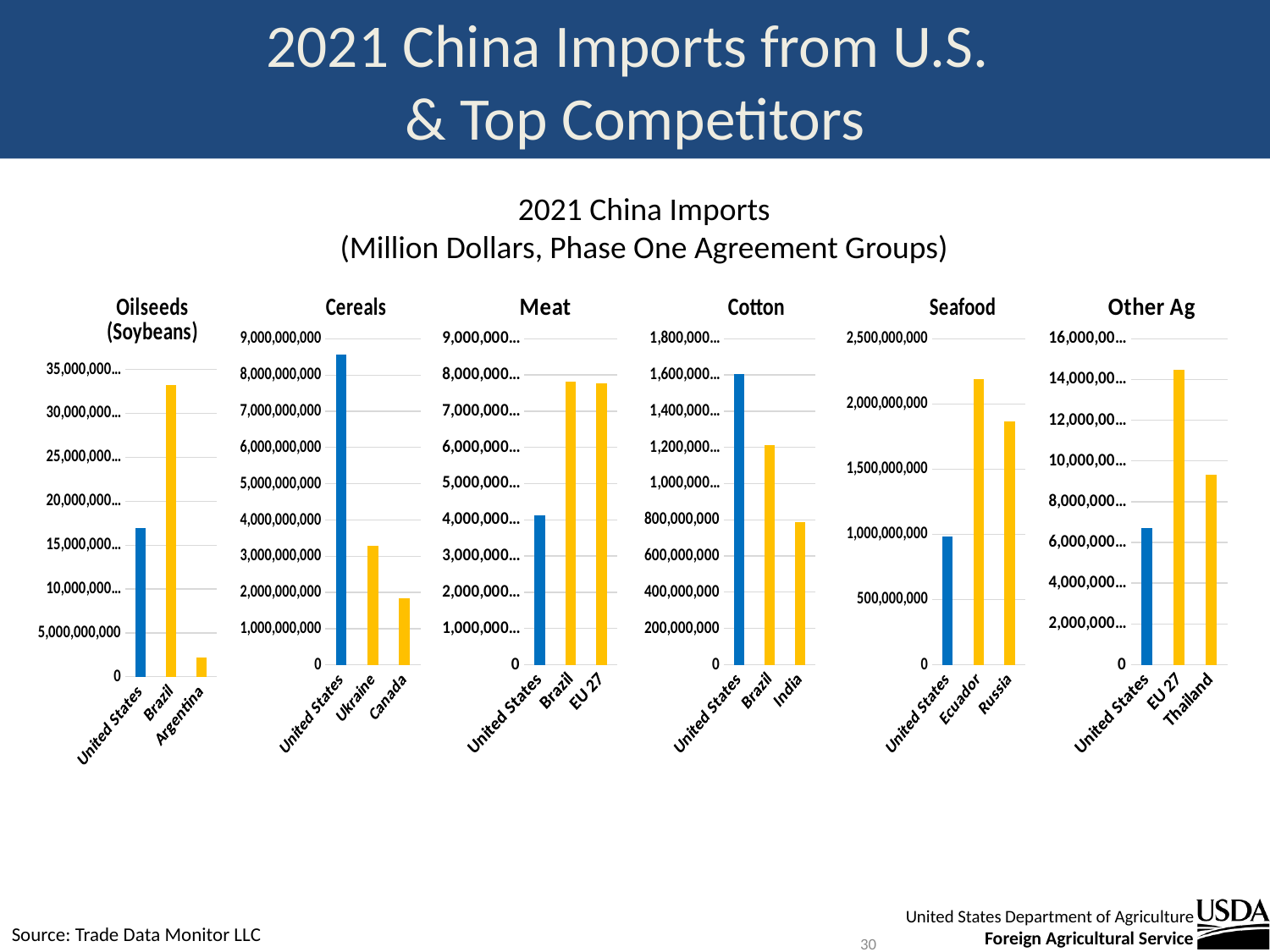
In the Other Ag chart, which country has the highest value? EU 27 In the Cereals chart, is the value for United States greater or less than 8,000,000,000? greater In the Meat chart, which country has the lowest value? United States In the Oilseeds (Soybeans) chart, which country has the highest value? Brazil In the Seafood chart, is the value for Russia greater or less than 1,500,000,000? greater What type of chart is the Cotton chart? Bar chart In the Cereals chart, which is larger, the value for Ukraine or the value for Canada? Ukraine In the Cotton chart, is the value for Brazil greater or less than 800,000,000? greater How many countries are shown in the Seafood chart? 3 In the Seafood chart, which country has the lowest value? United States In the Cereals chart, which country has the highest value? United States In the Cotton chart, which country has the lowest value? India